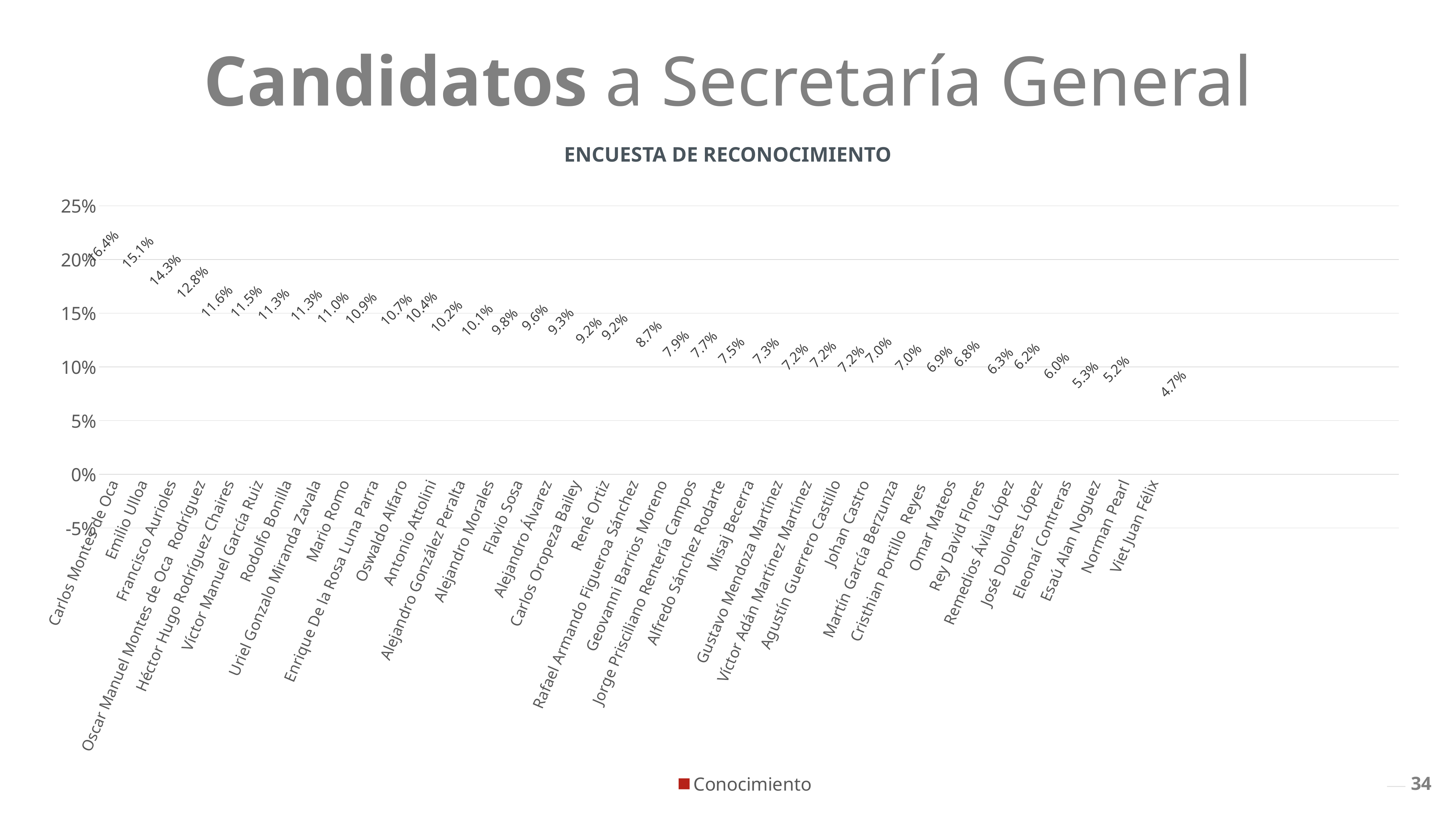
What is the Conocimiento value for Emilio Ulloa? 15.1% Which candidate has the highest Conocimiento value? Carlos Montes de Oca How many candidates are shown on the x axis of the chart? 37 What is the subtitle shown above the chart? ENCUESTA DE RECONOCIMIENTO Which candidate has the lowest Conocimiento value? Viet Juan Félix What is the Conocimiento value for Viet Juan Félix? 4.7% What is the Conocimiento value for Carlos Montes de Oca? 16.4% What is the difference between the Conocimiento values of Carlos Montes de Oca and Emilio Ulloa? 1.3% How many series does the legend list? 1 Which has a higher Conocimiento value, Francisco Aurioles or Oscar Manuel Montes de Oca Rodríguez? Francisco Aurioles Do the Conocimiento values rise or fall from left to right along the x axis? Fall What is the Conocimiento value for Norman Pearl? 5.2%